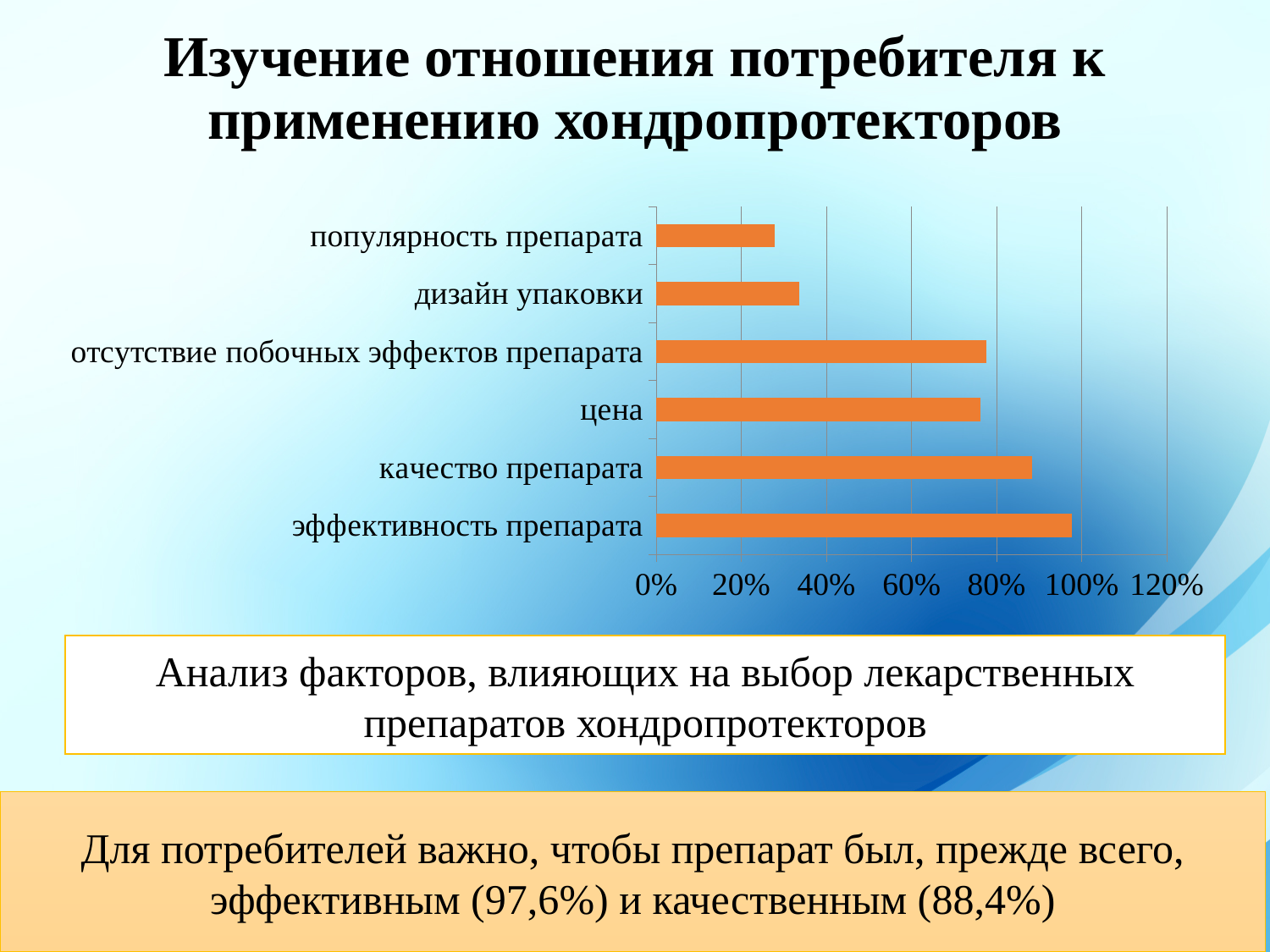
What is the value for эффективность препарата? 97,6% Which category has the lowest value in the chart? популярность препарата Which category has the highest value in the chart? эффективность препарата How many categories are plotted in the chart? 6 What kind of chart is shown on the slide? bar chart What is the difference between the values for эффективность препарата and качество препарата? 9,2% What is the highest value shown on the horizontal axis of the chart? 120% What is the value for качество препарата? 88,4% Is the value for цена greater or less than 60%? greater Which is larger, the value for качество препарата or the value for цена? качество препарата Is the value for отсутствие побочных эффектов препарата greater or less than 60%? greater Is the value for популярность препарата greater or less than 40%? less